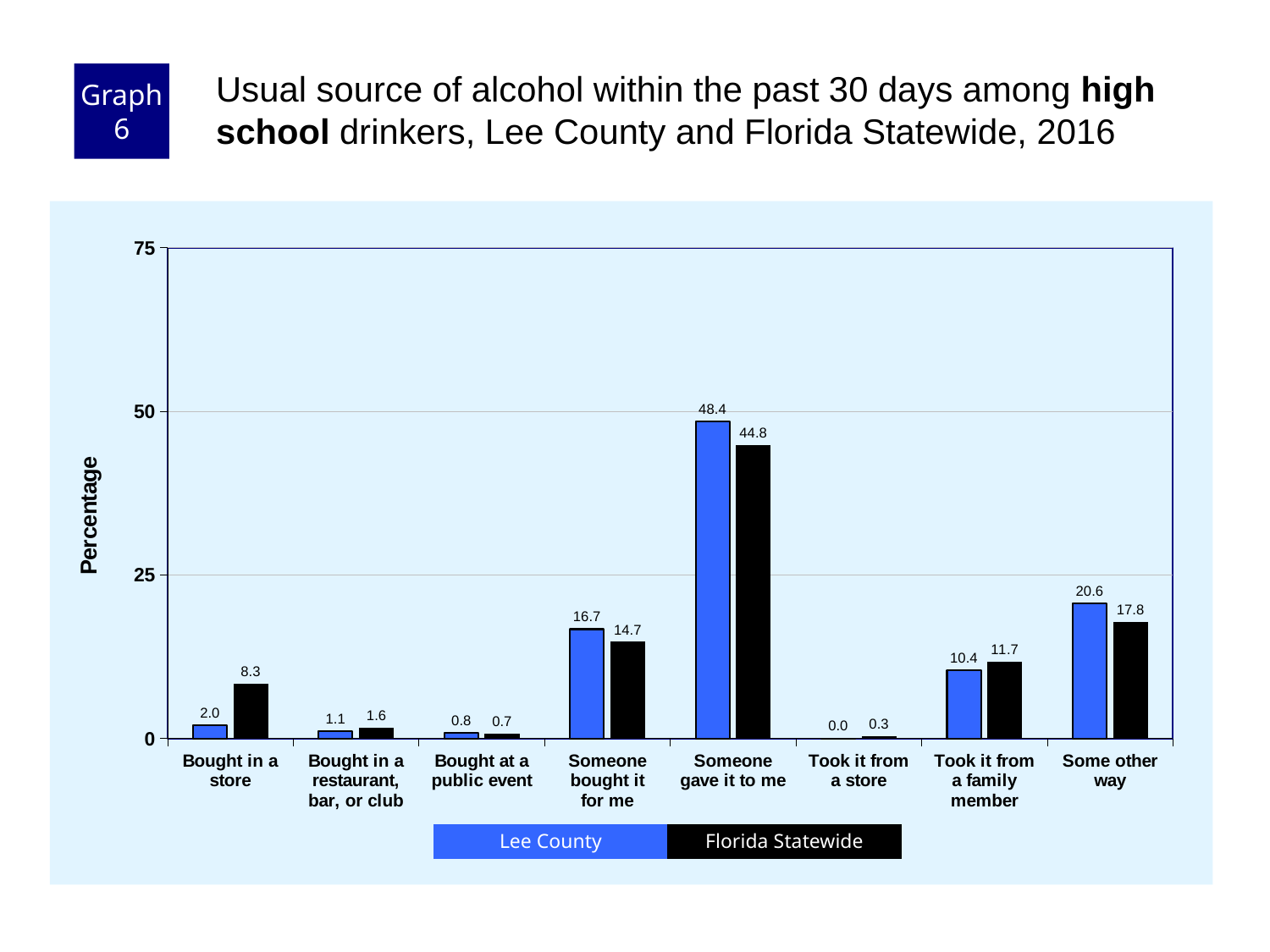
How many categories are shown on the x axis? 8 For "Someone bought it for me", which is larger: Lee County or Florida Statewide? Lee County What is the Lee County value for "Took it from a family member"? 10.4 Which category has the lowest Lee County value? Took it from a store What is the difference between the Lee County and Florida Statewide values for "Some other way"? 2.8 What is the Florida Statewide value for "Bought in a store"? 8.3 Which category has the highest Florida Statewide value? Someone gave it to me What is the Lee County value for "Someone gave it to me"? 48.4 What is the label of the y axis? Percentage Is the Florida Statewide value for "Someone gave it to me" greater or less than 25? greater What kind of chart is shown on the slide? Bar chart How many series does the legend list? 2